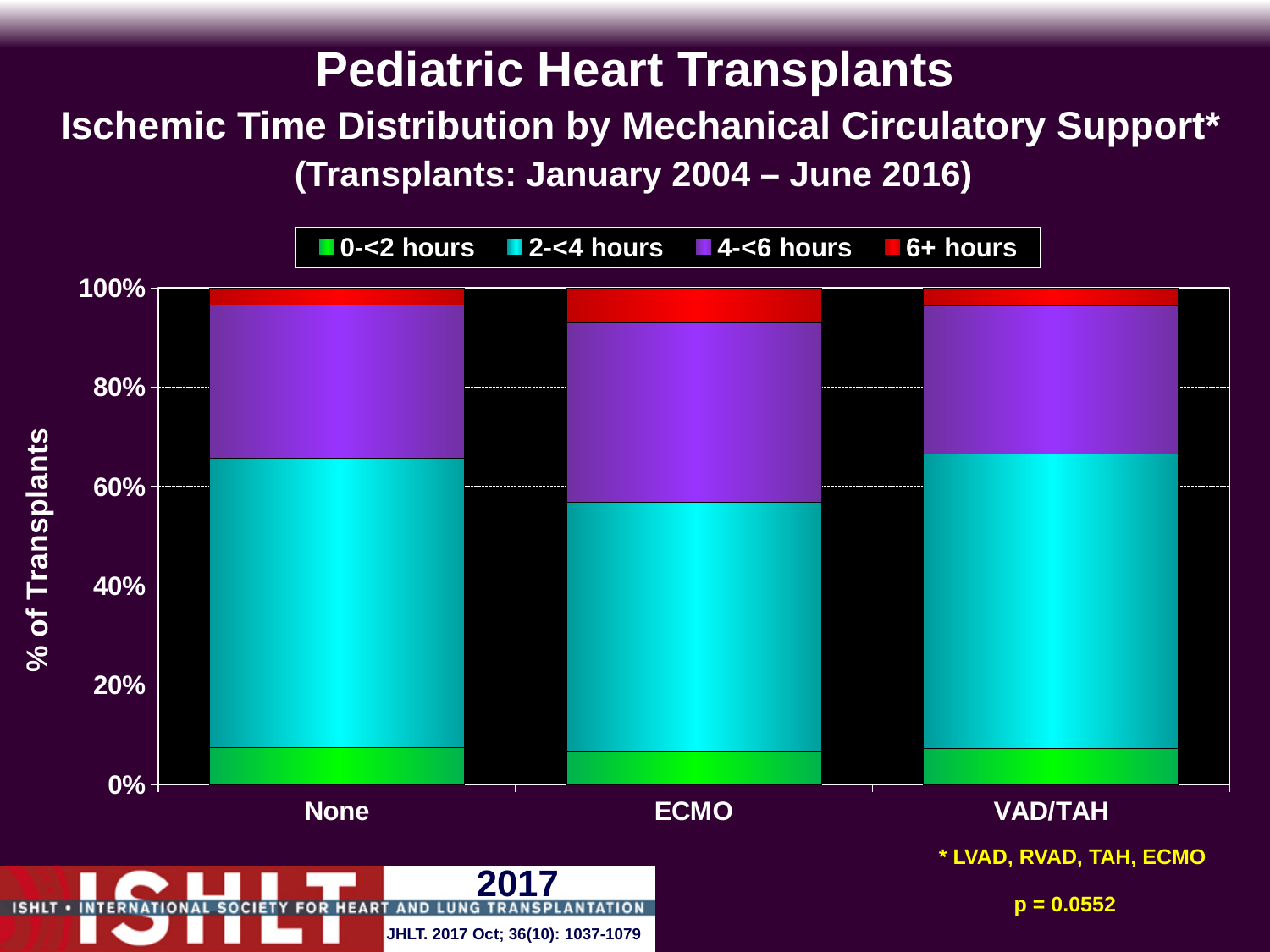
What p-value is shown on the slide? p = 0.0552 For None, is the cumulative share of transplants with ischemic time under 4 hours (top of the 2-<4 hours segment) greater or less than 60%? greater Is the 6+ hours segment larger for ECMO or for VAD/TAH? ECMO Which category has the largest 6+ hours segment? ECMO How many series does the legend list? 4 For VAD/TAH, is the cumulative share of transplants with ischemic time under 6 hours (top of the 4-<6 hours segment) greater or less than 80%? greater For ECMO, is the cumulative share of transplants with ischemic time under 4 hours (top of the 2-<4 hours segment) greater or less than 60%? less What is the label of the y axis? % of Transplants How many mechanical circulatory support categories are shown on the x axis? 3 Which category has the largest 4-<6 hours segment? ECMO Is the 4-<6 hours segment larger for ECMO or for None? ECMO What kind of chart is shown on the slide? Stacked bar chart